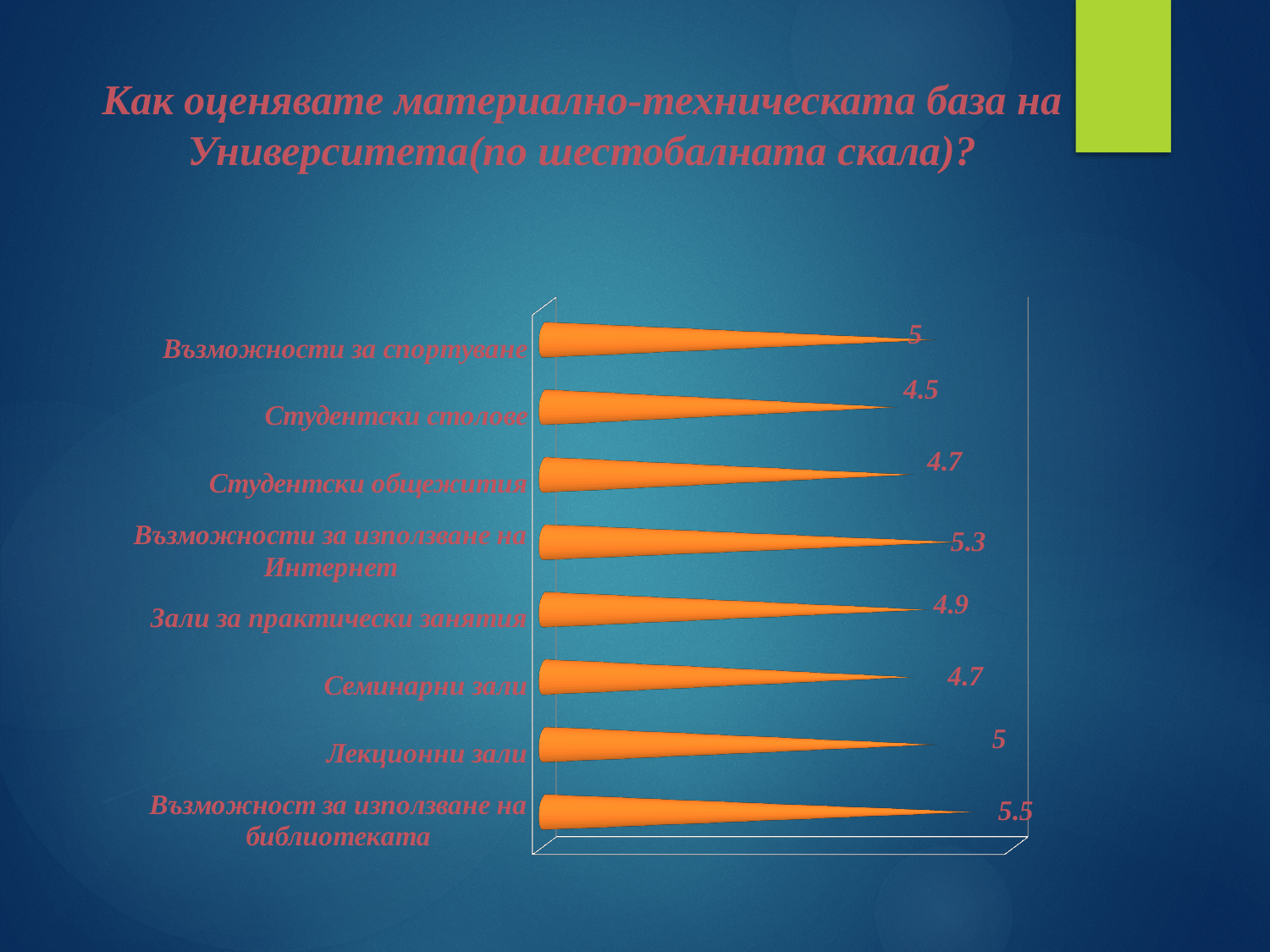
What is the difference between the values for Възможност за използване на библиотеката and Студентски столове? 1 What kind of chart is shown on the slide? Bar chart What is the value for Студентски столове? 4.5 What is the value for Зали за практически занятия? 4.9 Which category has the highest value? Възможност за използване на библиотеката What is the value for Възможности за използване на Интернет? 5.3 What is the title of the slide? Как оценявате материално-техническата база на Университета(по шестобалната скала)? What is the value for Възможности за спортуване? 5 What is the value for Възможност за използване на библиотеката? 5.5 Which category has the lowest value? Студентски столове How many categories are shown in the chart? 8 Which is larger: the value for Възможности за използване на Интернет or the value for Зали за практически занятия? Възможности за използване на Интернет